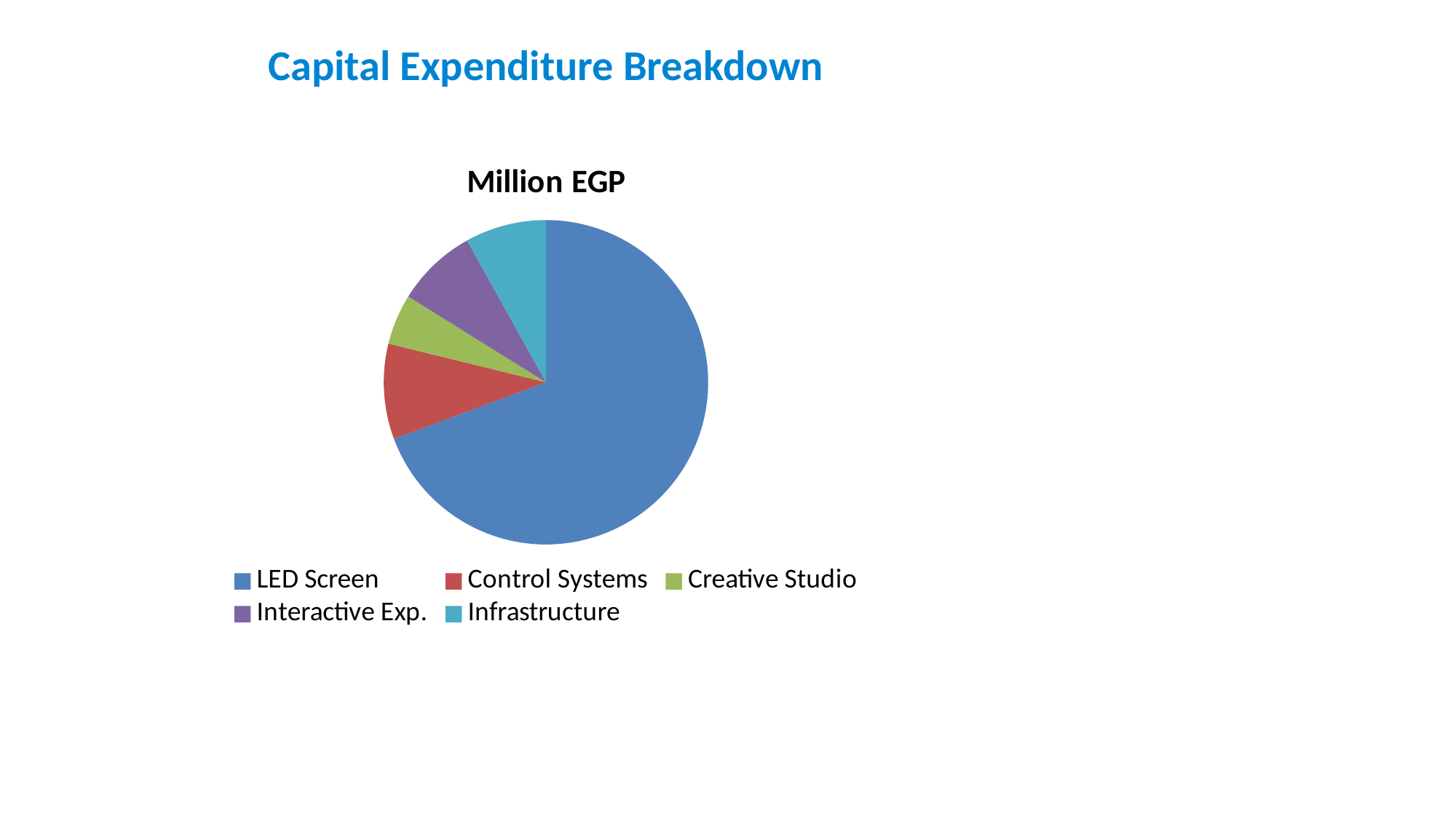
Which is larger, the slice for Infrastructure or the slice for Creative Studio? Infrastructure How many slices does the pie chart have? 5 What kind of chart is shown on the slide? Pie chart What colour is the Control Systems slice in the pie chart? Red What is the title of the chart? Million EGP Which category has the largest slice of the pie chart? LED Screen Which is larger, the slice for LED Screen or the slice for Control Systems? LED Screen Which category has the smallest slice of the pie chart? Creative Studio Does the LED Screen slice account for more or less than half of the pie? more Which is larger, the slice for Control Systems or the slice for Creative Studio? Control Systems